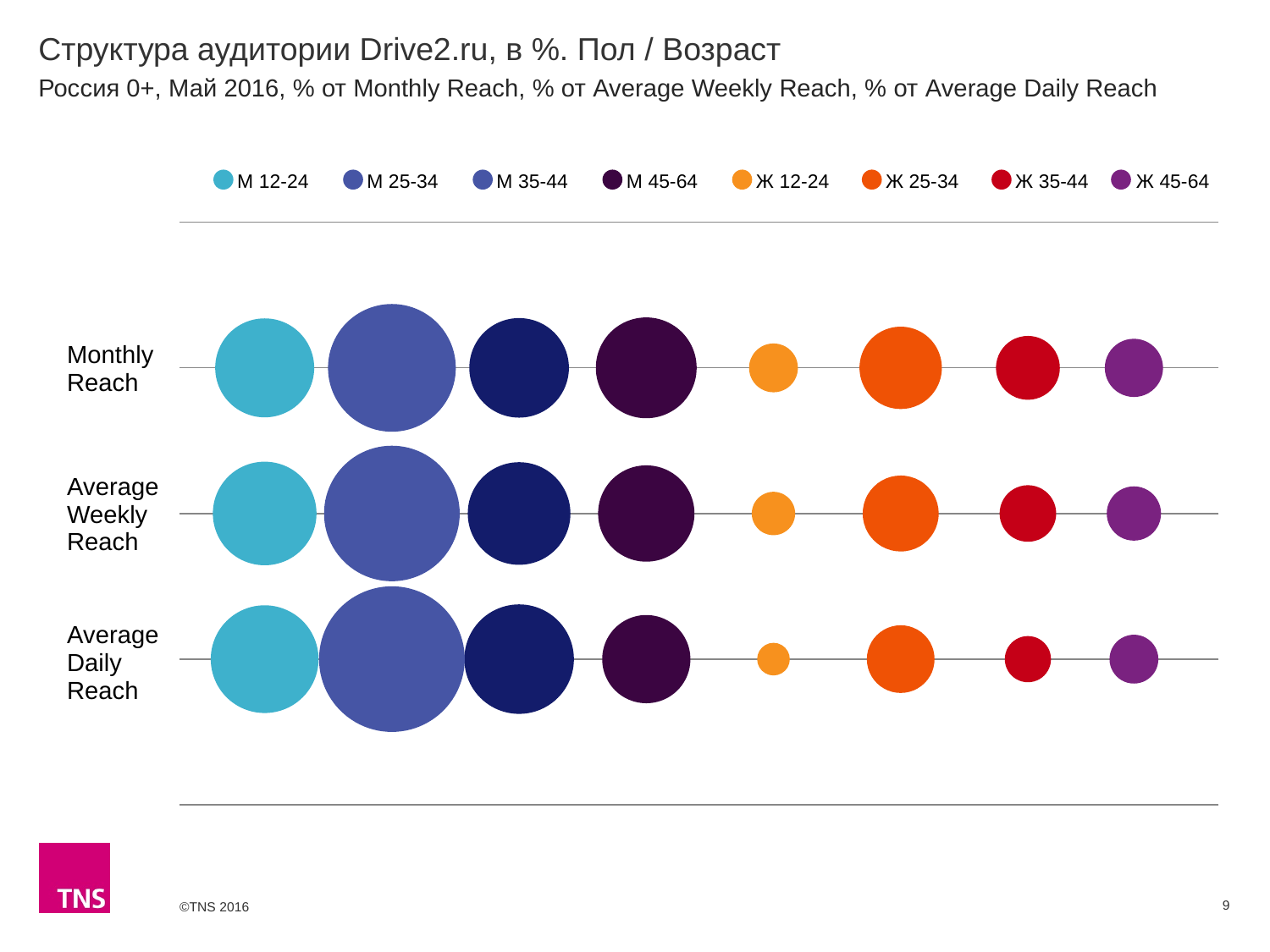
Which gender/age group has the smallest bubble in the Average Weekly Reach row? Ж 12-24 What month and year does the subtitle say the data is for? Май 2016 Which website's audience structure does the chart title refer to? Drive2.ru In the Average Daily Reach row, which bubble is larger: Ж 25-34 or Ж 35-44? Ж 25-34 Which gender/age group has the largest bubble in the Monthly Reach row? М 25-34 Which gender/age group has the smallest bubble in the Monthly Reach row? Ж 12-24 Which gender/age group has the largest bubble in the Average Daily Reach row? М 25-34 In the Monthly Reach row, which bubble is larger: М 12-24 or Ж 12-24? М 12-24 How many reach categories (rows) are plotted in the chart? 3 In the Average Weekly Reach row, which bubble is larger: М 45-64 or Ж 45-64? М 45-64 What kind of chart is shown on the slide? Bubble chart How many series does the legend list? 8